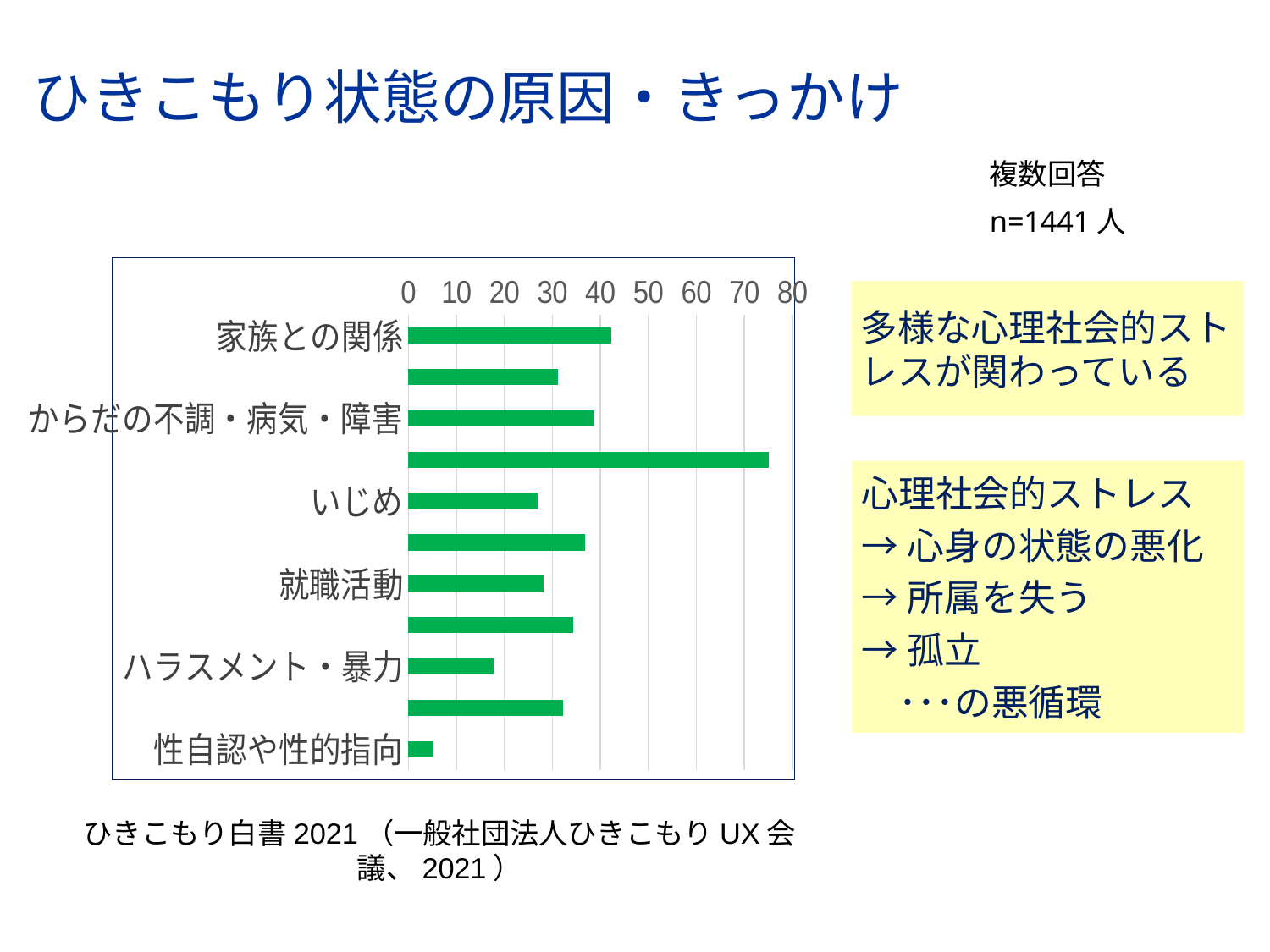
What kind of chart is shown on the slide? bar chart Which has the larger value, からだの不調・病気・障害 or ハラスメント・暴力? からだの不調・病気・障害 Is the value for からだの不調・病気・障害 greater or less than 30? greater Is the value for いじめ greater or less than 40? less Is the value for 就職活動 greater or less than 40? less Which labeled category has the lowest value in the chart? 性自認や性的指向 Which has the larger value, 家族との関係 or いじめ? 家族との関係 What is the title of the slide containing the chart? ひきこもり状態の原因・きっかけ How many bars are plotted in the chart? 11